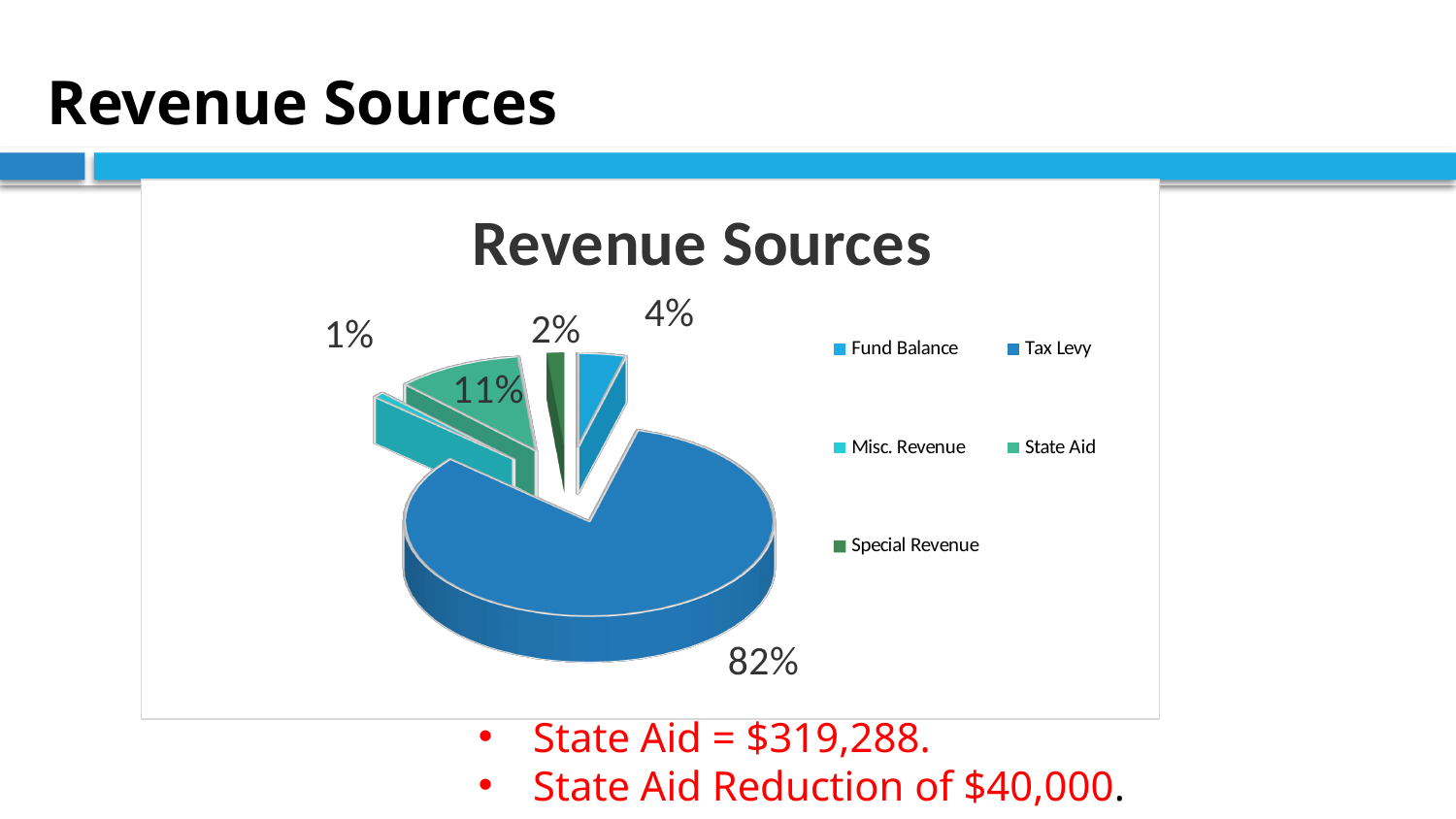
How many revenue sources are shown in the pie chart? 5 What percentage is shown for State Aid? 11% What percentage is shown for Special Revenue? 2% What percentage is shown for Fund Balance? 4% What is the difference in percentage points between Tax Levy and State Aid? 71 Which is larger, the share for Fund Balance or the share for Special Revenue? Fund Balance What share of the pie does Tax Levy represent? 82% What percentage is shown for Misc. Revenue? 1% What is the title of the chart? Revenue Sources What type of chart is shown on the slide? Pie chart Which revenue source has the smallest share of the pie? Misc. Revenue Which revenue source has the largest share of the pie? Tax Levy